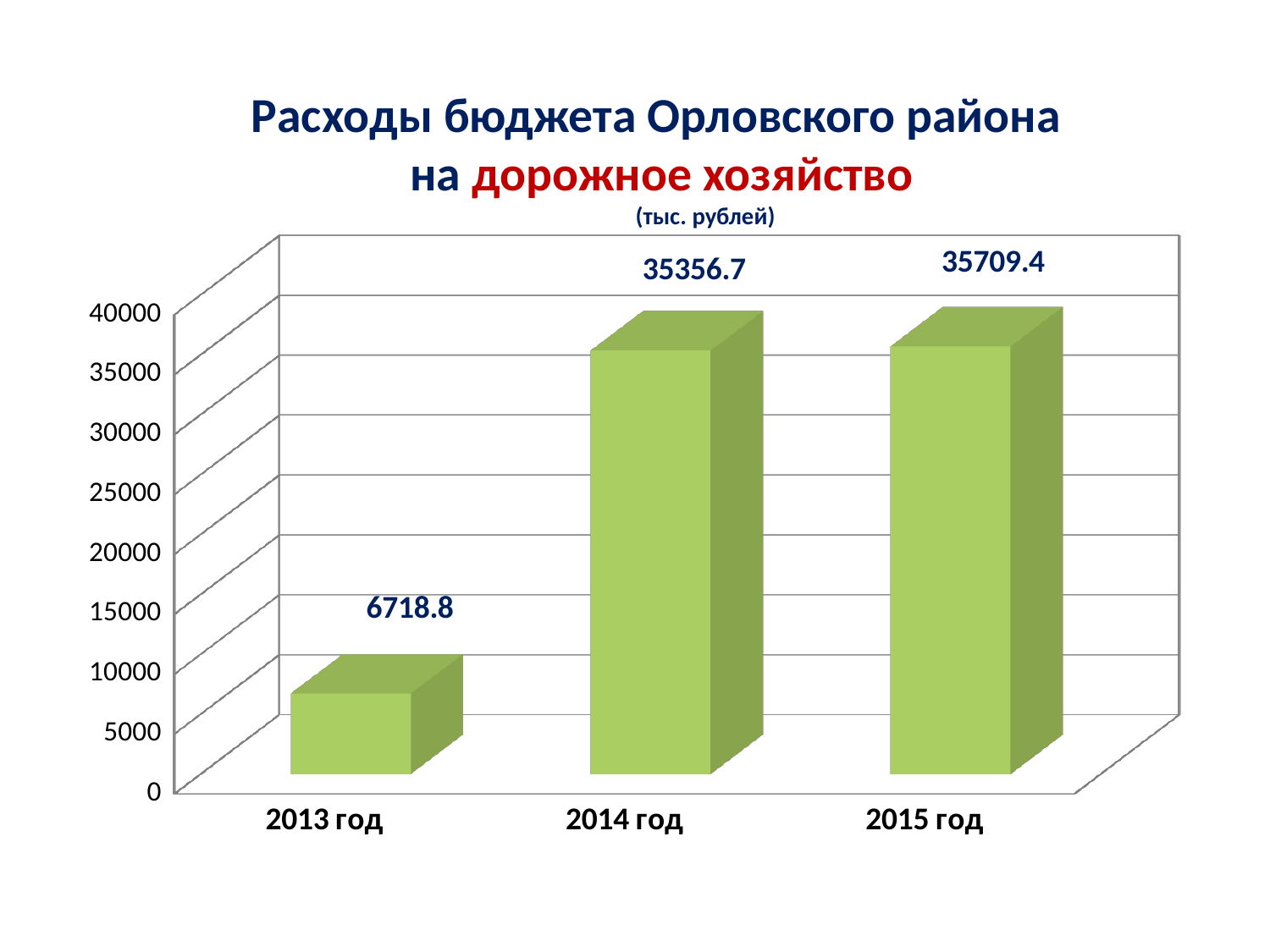
How many years are shown on the chart? 3 What is the difference between the values for 2015 год and 2014 год? 352.7 What is the value for 2015 год? 35709.4 What is the difference between the values for 2014 год and 2013 год? 28637.9 What kind of chart is shown on the slide? bar chart What is the value for 2013 год? 6718.8 Is the value for 2013 год greater or less than 10000? less In what units are the values on the chart given, according to the subtitle? тыс. рублей Which year has the highest value? 2015 год Which year has the lowest value? 2013 год What is the value for 2014 год? 35356.7 Which is larger, the value for 2014 год or 2015 год? 2015 год